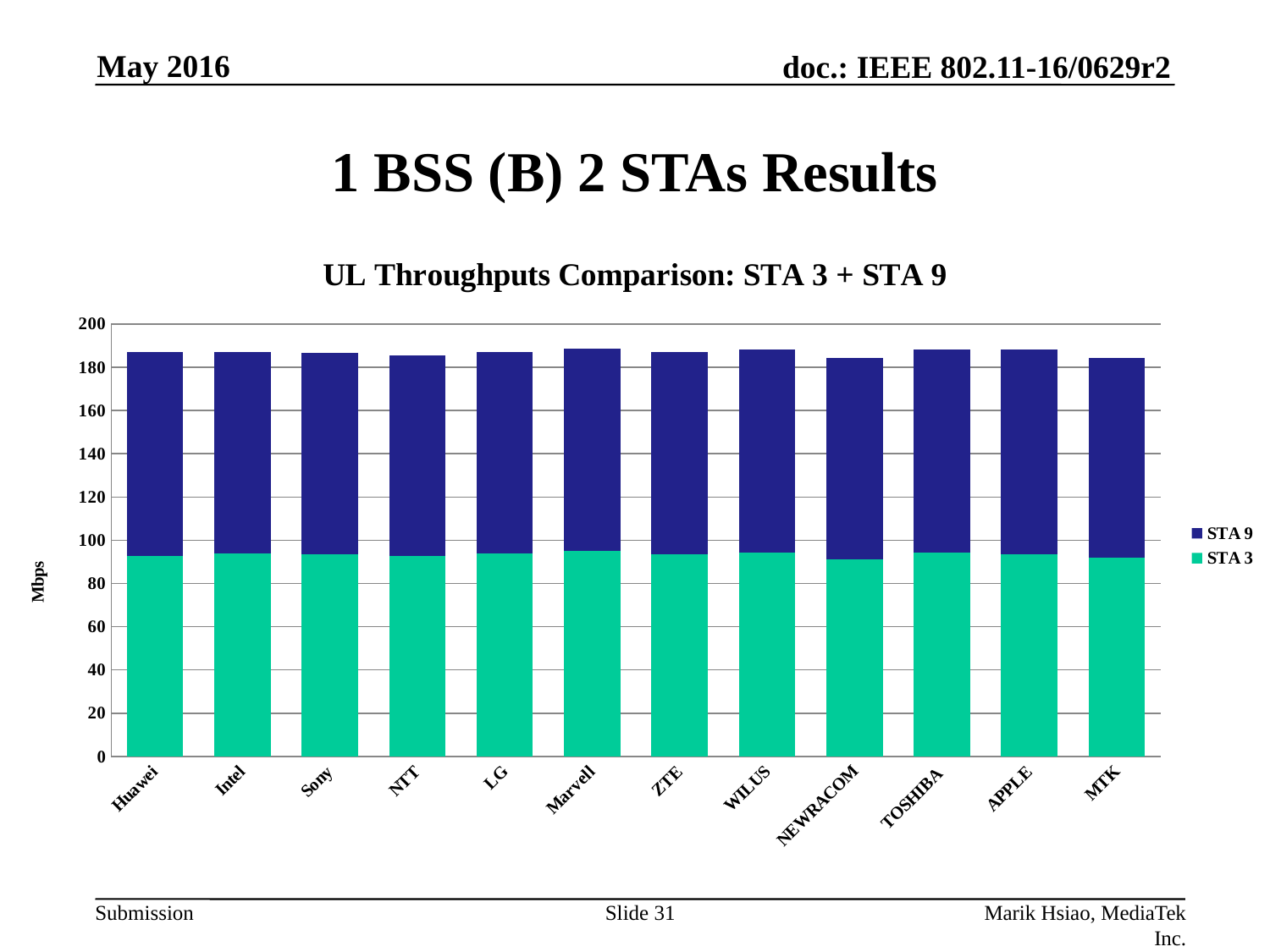
Is the STA 3 value for NEWRACOM greater or less than 60? greater What unit is shown on the y axis? Mbps What kind of chart is shown on the slide? stacked bar chart What is the title of the chart? UL Throughputs Comparison: STA 3 + STA 9 Is the STA 3 value for Marvell greater or less than 100? less Is the total stacked value for TOSHIBA greater or less than 160? greater How many series does the legend list? 2 How many companies are shown on the x axis? 12 Which series are listed in the legend? STA 9 and STA 3